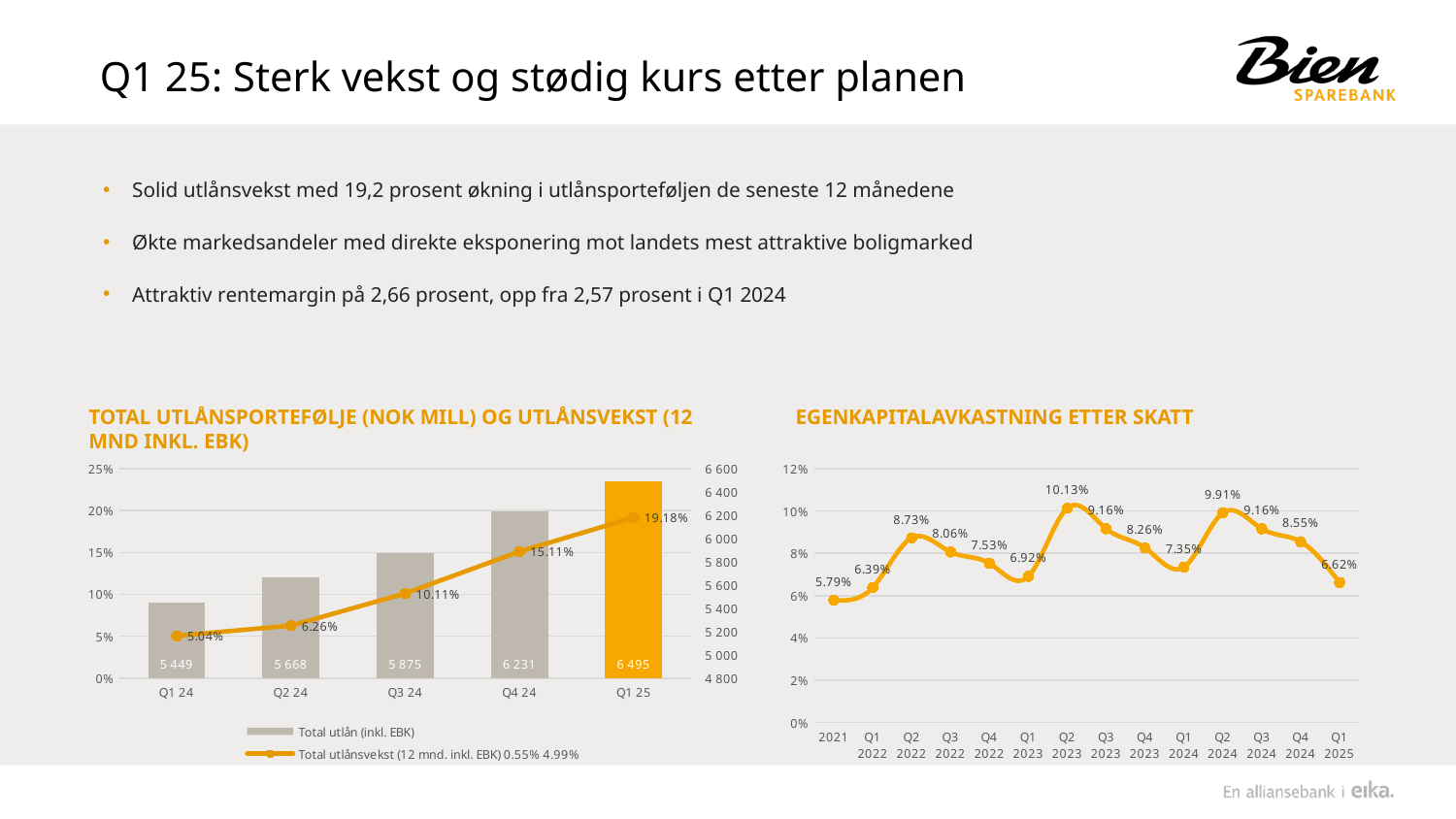
In the chart 'TOTAL UTLÅNSPORTEFØLJE (NOK MILL) OG UTLÅNSVEKST (12 MND INKL. EBK)', how many series does the legend list? 2 In the chart 'TOTAL UTLÅNSPORTEFØLJE (NOK MILL) OG UTLÅNSVEKST (12 MND INKL. EBK)', what is the loan growth percentage shown for Q3 24? 10.11% What kind of chart is 'EGENKAPITALAVKASTNING ETTER SKATT'? Line chart In the chart 'EGENKAPITALAVKASTNING ETTER SKATT', which is larger, the value for Q2 2024 or the value for Q4 2024? Q2 2024 In the chart 'EGENKAPITALAVKASTNING ETTER SKATT', which period has the lowest value? 2021 In the chart 'TOTAL UTLÅNSPORTEFØLJE (NOK MILL) OG UTLÅNSVEKST (12 MND INKL. EBK)', does the loan growth line rise or fall from Q1 24 to Q1 25? Rises In the chart 'TOTAL UTLÅNSPORTEFØLJE (NOK MILL) OG UTLÅNSVEKST (12 MND INKL. EBK)', which quarter has the lowest total loan portfolio value? Q1 24 In the chart 'TOTAL UTLÅNSPORTEFØLJE (NOK MILL) OG UTLÅNSVEKST (12 MND INKL. EBK)', what is the total loan portfolio value for Q1 25? 6 495 In the chart 'TOTAL UTLÅNSPORTEFØLJE (NOK MILL) OG UTLÅNSVEKST (12 MND INKL. EBK)', what is the difference between the total loan portfolio in Q1 25 and Q1 24? 1 046 In the chart 'TOTAL UTLÅNSPORTEFØLJE (NOK MILL) OG UTLÅNSVEKST (12 MND INKL. EBK)', how many quarters are shown on the x axis? 5 In the chart 'EGENKAPITALAVKASTNING ETTER SKATT', what is the value for Q1 2025? 6.62% In the chart 'EGENKAPITALAVKASTNING ETTER SKATT', which period has the highest value? Q2 2023